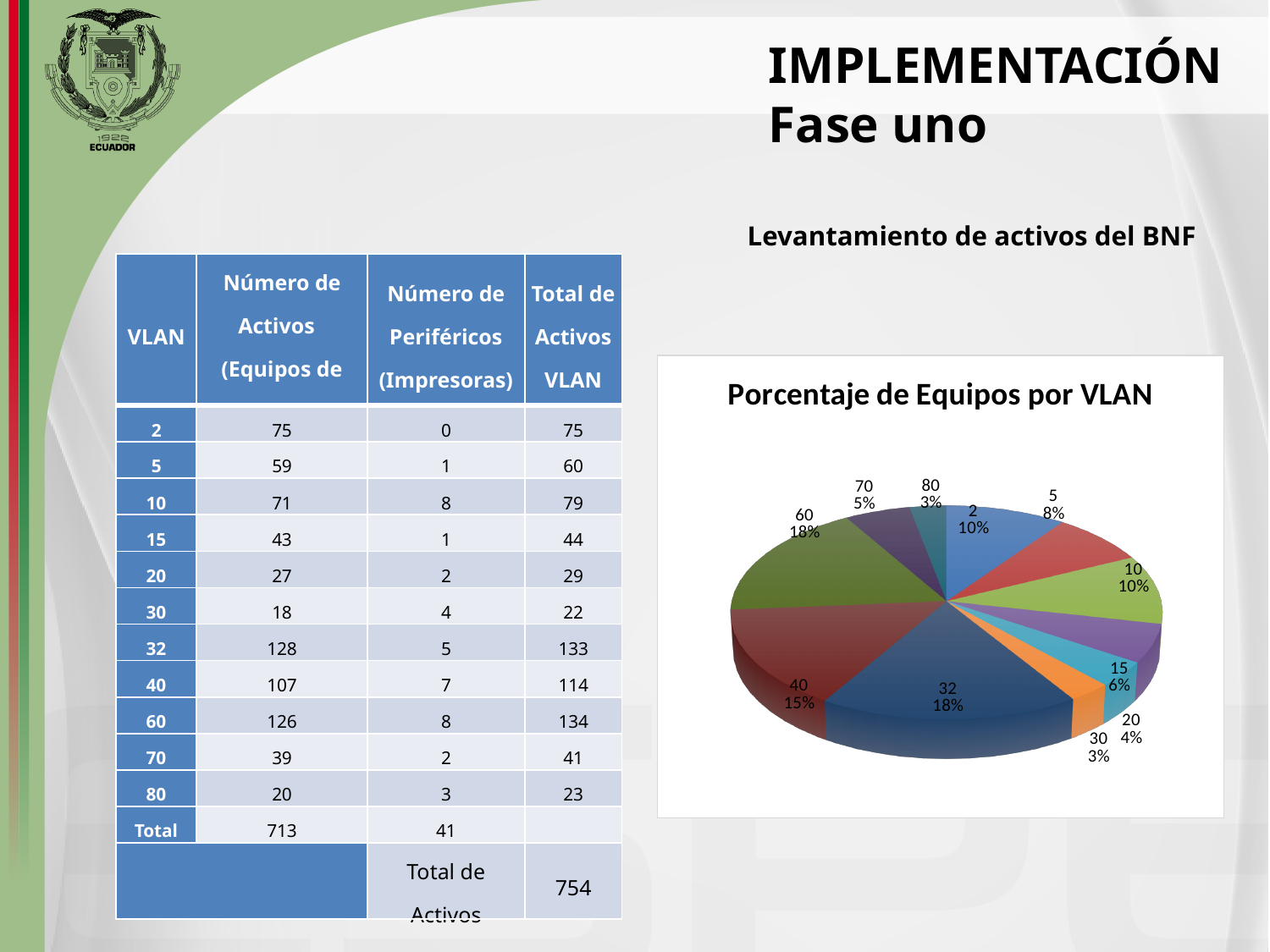
How many slices does the pie chart "Porcentaje de Equipos por VLAN" have? 11 In the pie chart, what percentage is shown for VLAN 40? 15% In the pie chart, what percentage is shown for VLAN 5? 8% In the pie chart, which has the larger share, VLAN 5 or VLAN 20? VLAN 5 In the pie chart, what share does VLAN 60 have? 18% In the pie chart, what percentage is shown for VLAN 70? 5% In the pie chart, what is the difference in percentage points between VLAN 40 and VLAN 20? 11 What type of chart is shown under the title "Porcentaje de Equipos por VLAN"? pie chart In the pie chart, what percentage is shown for VLAN 32? 18% In the pie chart, which has the larger share, VLAN 40 or VLAN 60? VLAN 60 What is the title of the chart on the slide? Porcentaje de Equipos por VLAN In the pie chart, what percentage is shown for VLAN 15? 6%